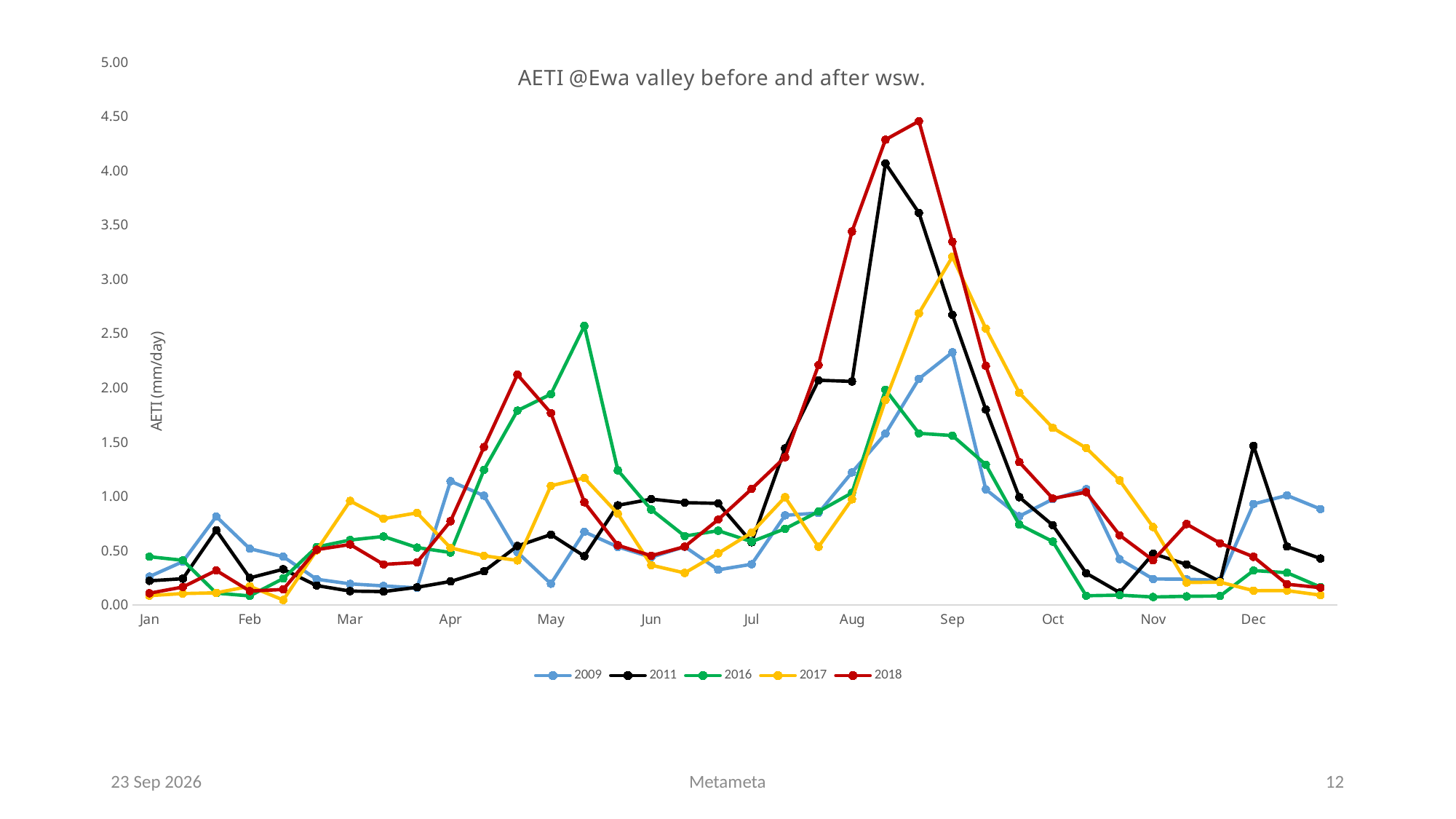
Around late August, which series is higher: 2018 or 2016? 2018 Is the peak value of the 2009 series greater or less than 2.00? greater Does the 2017 series rise or fall from September to December? fall Which series reaches the highest value during May? 2016 What kind of chart is shown on the slide? line chart What is the label of the vertical axis? AETI (mm/day) Is the peak value of the 2017 series greater or less than 3.00? greater How many series does the legend list? 5 What is the title of the chart? AETI @Ewa valley before and after wsw. Which series reaches the highest value anywhere on the chart? 2018 How many month labels are shown on the x axis? 12 Is the peak value of the 2018 series greater or less than 4.00? greater